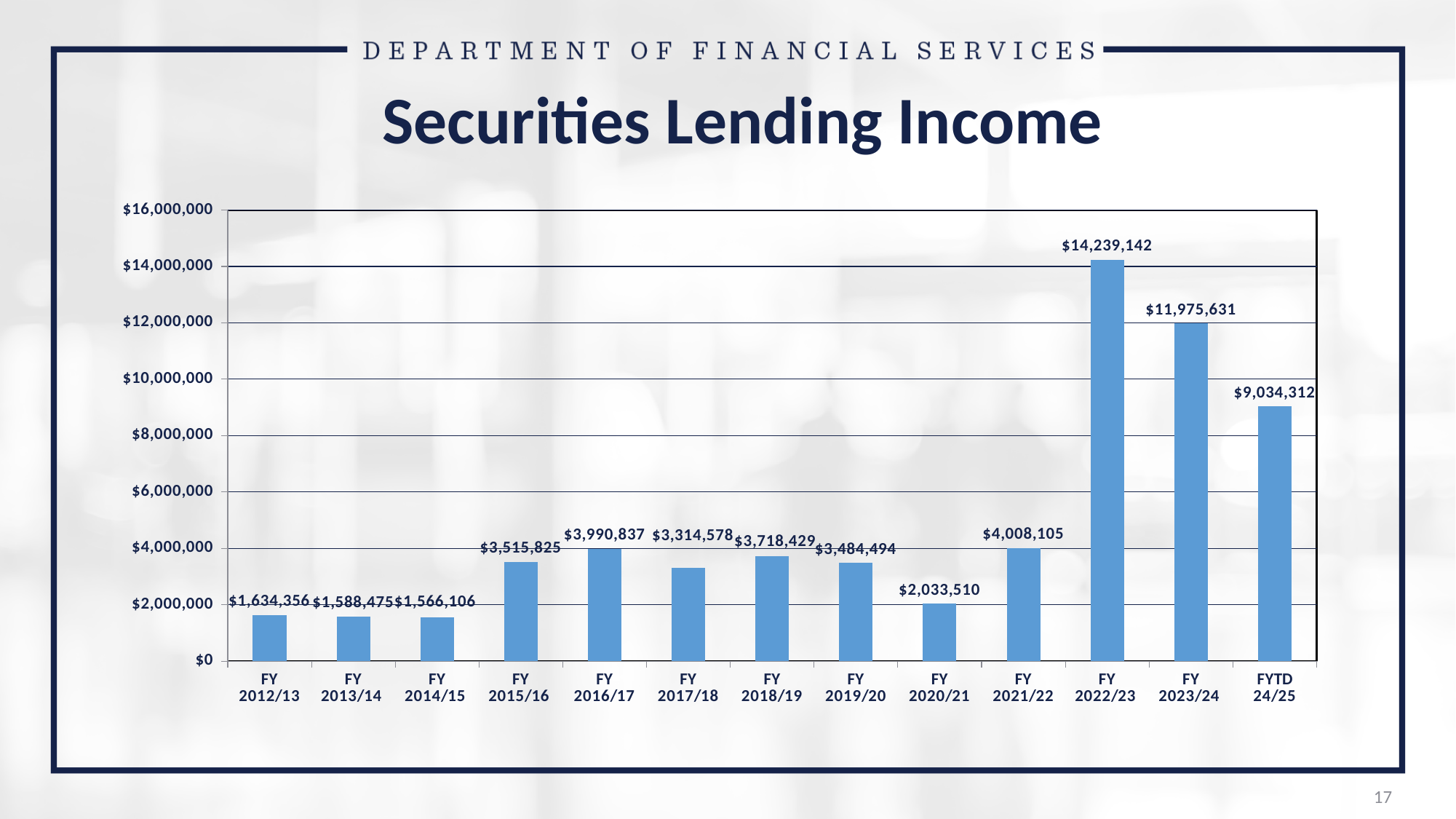
What is the difference in Securities Lending Income between FY 2022/23 and FY 2023/24? $2,263,511 Which is larger, the Securities Lending Income for FY 2018/19 or FY 2017/18? FY 2018/19 Which fiscal year has the highest Securities Lending Income? FY 2022/23 Is the Securities Lending Income for FY 2023/24 greater or less than $10,000,000? greater What is the Securities Lending Income for FYTD 24/25? $9,034,312 How many fiscal years are shown on the chart? 13 What is the difference in Securities Lending Income between FY 2021/22 and FY 2020/21? $1,974,595 Which fiscal year has the lowest Securities Lending Income? FY 2014/15 What is the Securities Lending Income for FY 2022/23? $14,239,142 What kind of chart is used to show Securities Lending Income? bar chart What is the title of the chart on the slide? Securities Lending Income What is the Securities Lending Income for FY 2020/21? $2,033,510